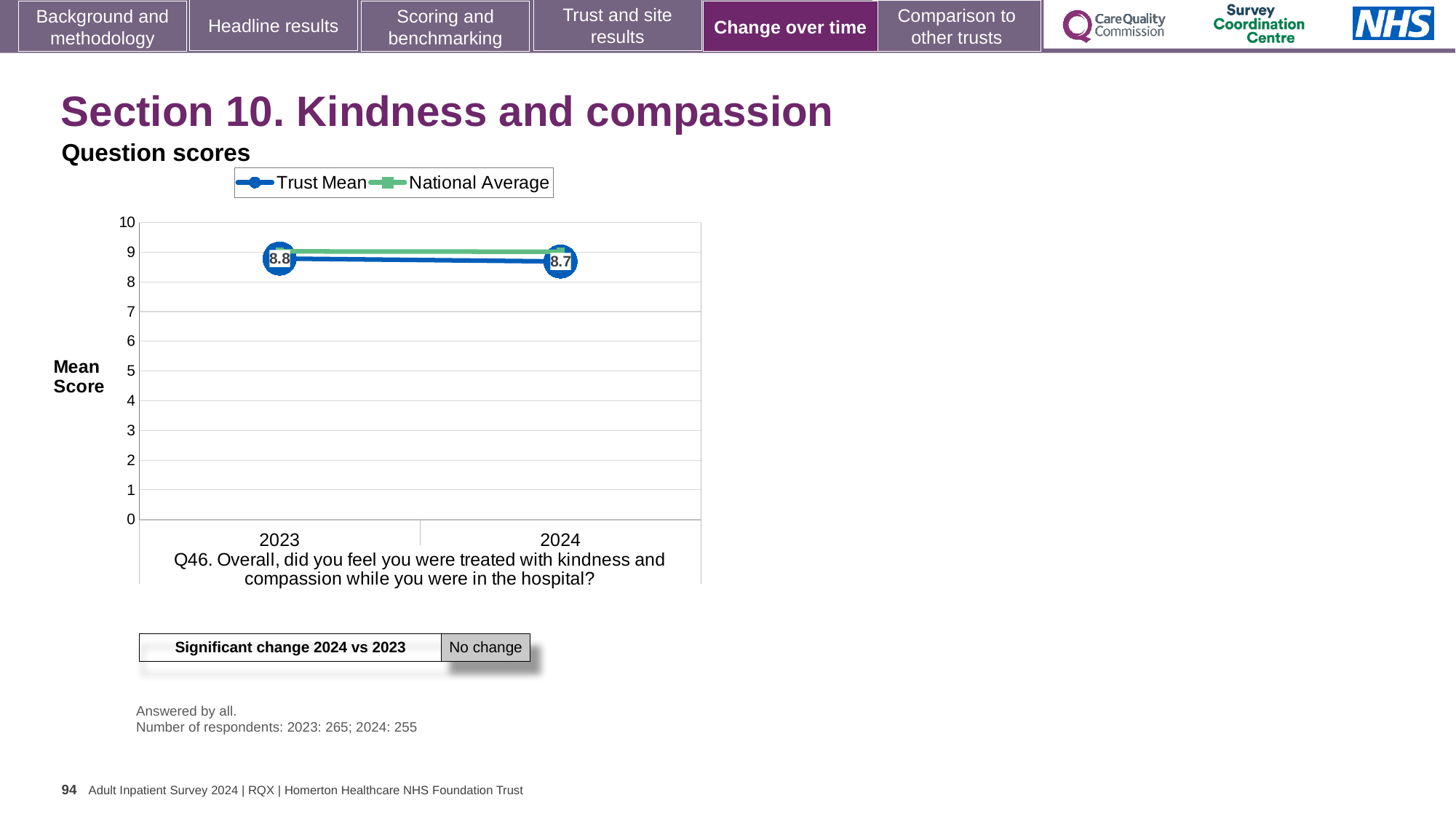
What kind of chart is shown on the slide? Line chart By how much did the Trust Mean score change from 2023 to 2024? 0.1 What is the label on the y axis of the chart? Mean Score Which year has the higher Trust Mean score, 2023 or 2024? 2023 Is the Trust Mean value for 2024 greater or less than 8? greater In 2024, which series is higher, Trust Mean or National Average? National Average Does the Trust Mean rise or fall from 2023 to 2024? Fall Is the National Average value for 2023 greater or less than 5? greater What is the Trust Mean score for 2024? 8.7 How many series does the legend list? 2 How many years are plotted on the x axis? 2 What is the Trust Mean score for 2023? 8.8